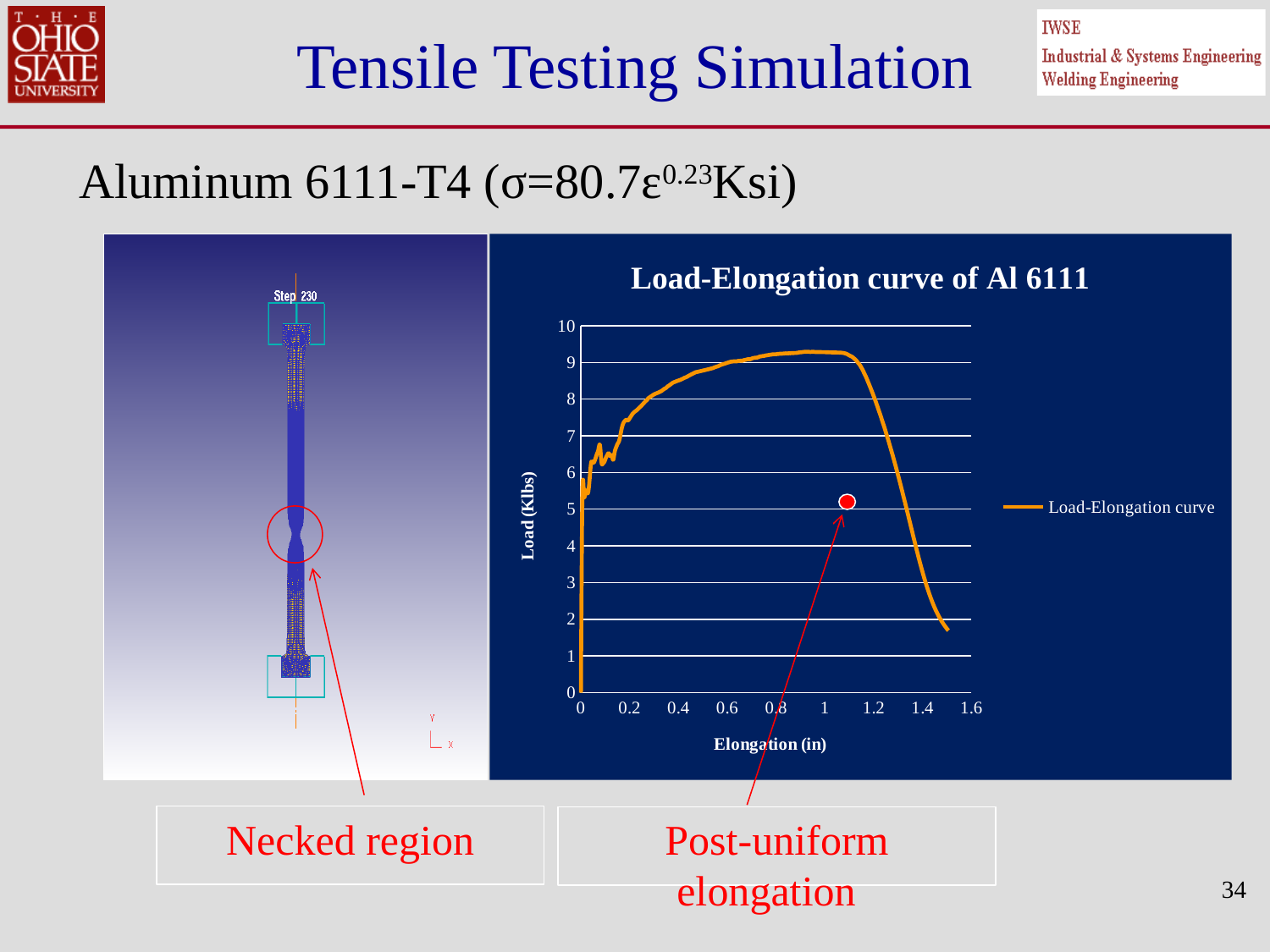
Is the load at an elongation of 0.2 in greater or less than 6? greater Is the maximum load reached on the curve greater or less than 10? less Does the load rise or fall as elongation increases from 0 to 0.6 in? rise Is the load at an elongation of 1.0 in greater or less than 8? greater Which is larger, the load at an elongation of 0.6 in or the load at an elongation of 1.4 in? 0.6 in How many series does the chart legend list? 1 Does the load rise or fall as elongation increases from 1.2 in to 1.5 in? fall What type of chart is shown on the slide? line chart What is the title of the chart? Load-Elongation curve of Al 6111 What is the label of the y axis of the chart? Load (Klbs)